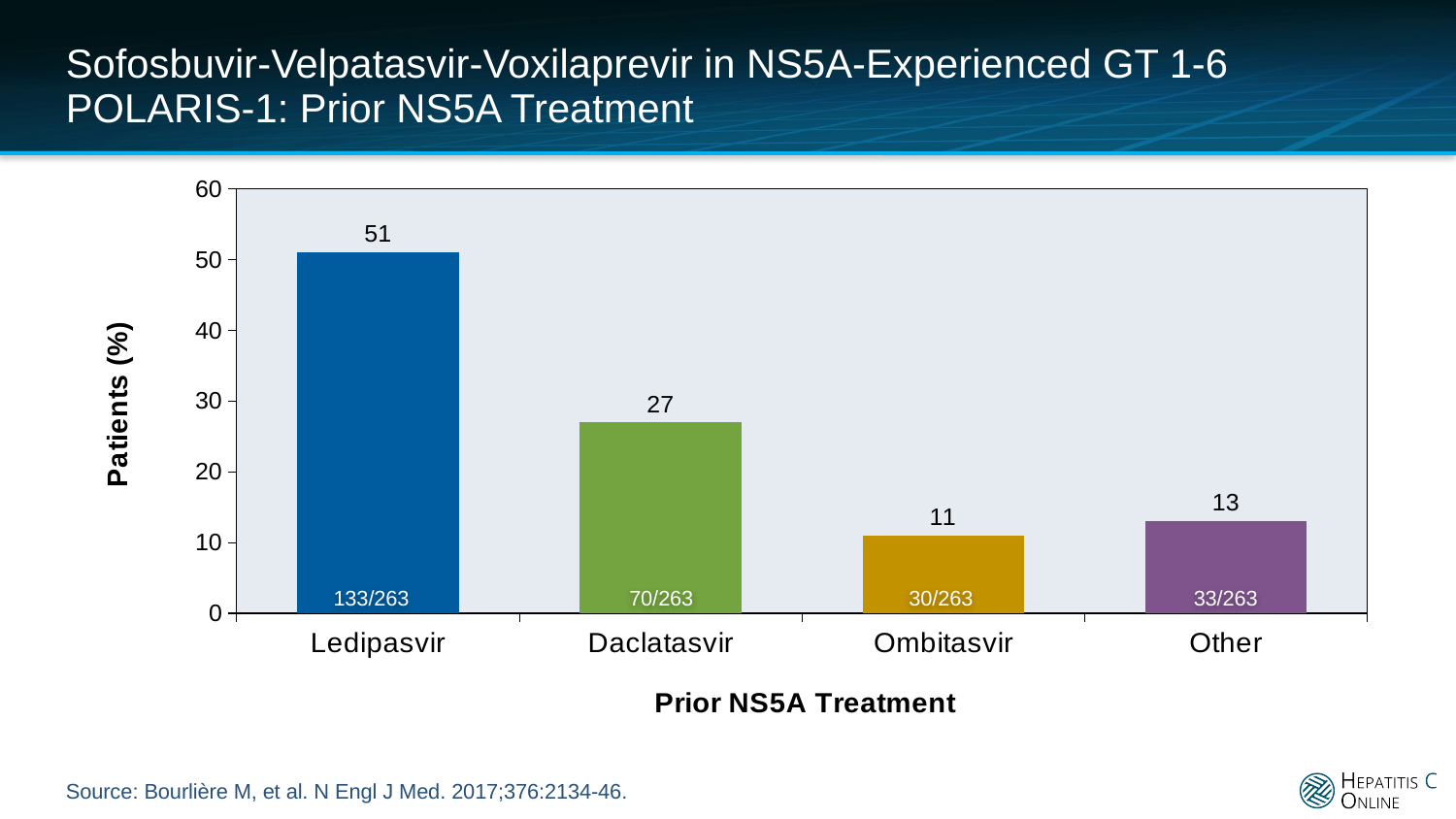
Which prior NS5A treatment category has the highest percentage of patients? Ledipasvir What is the difference in percentage points between Ledipasvir and Daclatasvir? 24 Which prior NS5A treatment category has the lowest percentage of patients? Ombitasvir What is the label of the y-axis? Patients (%) What percentage of patients had prior Ledipasvir treatment? 51 What percentage of patients had prior Daclatasvir treatment? 27 Is the value for Ledipasvir greater or less than 40? greater Which has a higher percentage of patients, Daclatasvir or Other? Daclatasvir What kind of chart is shown on the slide? Bar chart How many prior NS5A treatment categories are shown on the chart? 4 What percentage of patients had prior Ombitasvir treatment? 11 What fraction of patients is shown for the Other category? 33/263